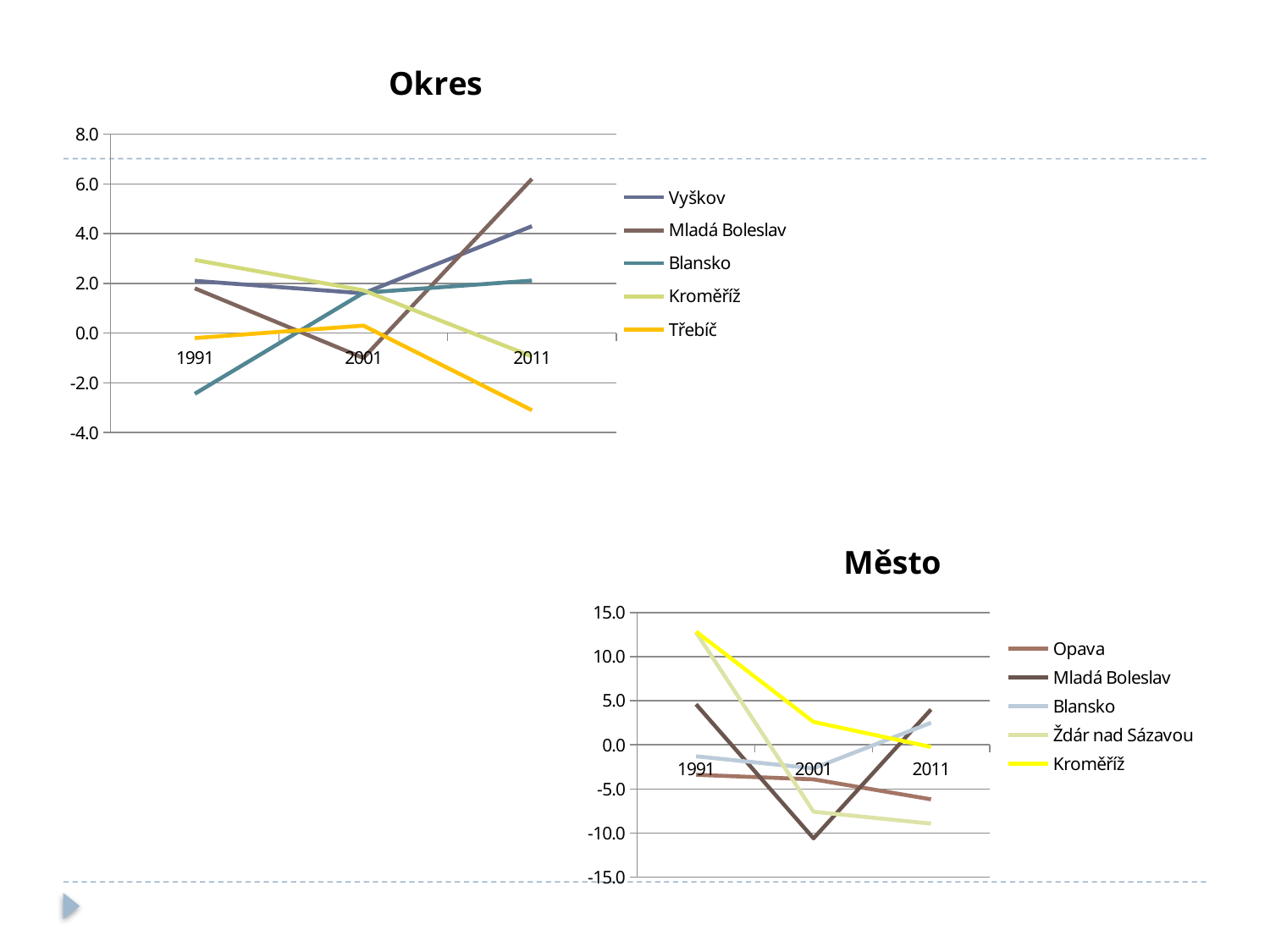
In the "Okres" chart, is the value for Mladá Boleslav in 2011 greater or less than 4.0? greater In the "Město" chart, is the value for Kroměříž in 1991 greater or less than 10.0? greater In the "Okres" chart, does the Třebíč line rise or fall from 2001 to 2011? fall In the "Okres" chart, is the value for Třebíč in 2011 greater or less than -2.0? less In the "Město" chart, which is larger in 2011: Mladá Boleslav or Opava? Mladá Boleslav In the "Okres" chart, which series has the highest value in 2011? Mladá Boleslav In the "Okres" chart, which series has the lowest value in 1991? Blansko In the "Město" chart, does the Opava line rise or fall from 1991 to 2011? fall What kind of chart is the "Okres" chart? line chart How many series does the legend of the "Okres" chart list? 5 In the "Město" chart, which series has the lowest value in 2001? Mladá Boleslav How many years are shown on the x axis of the "Město" chart? 3